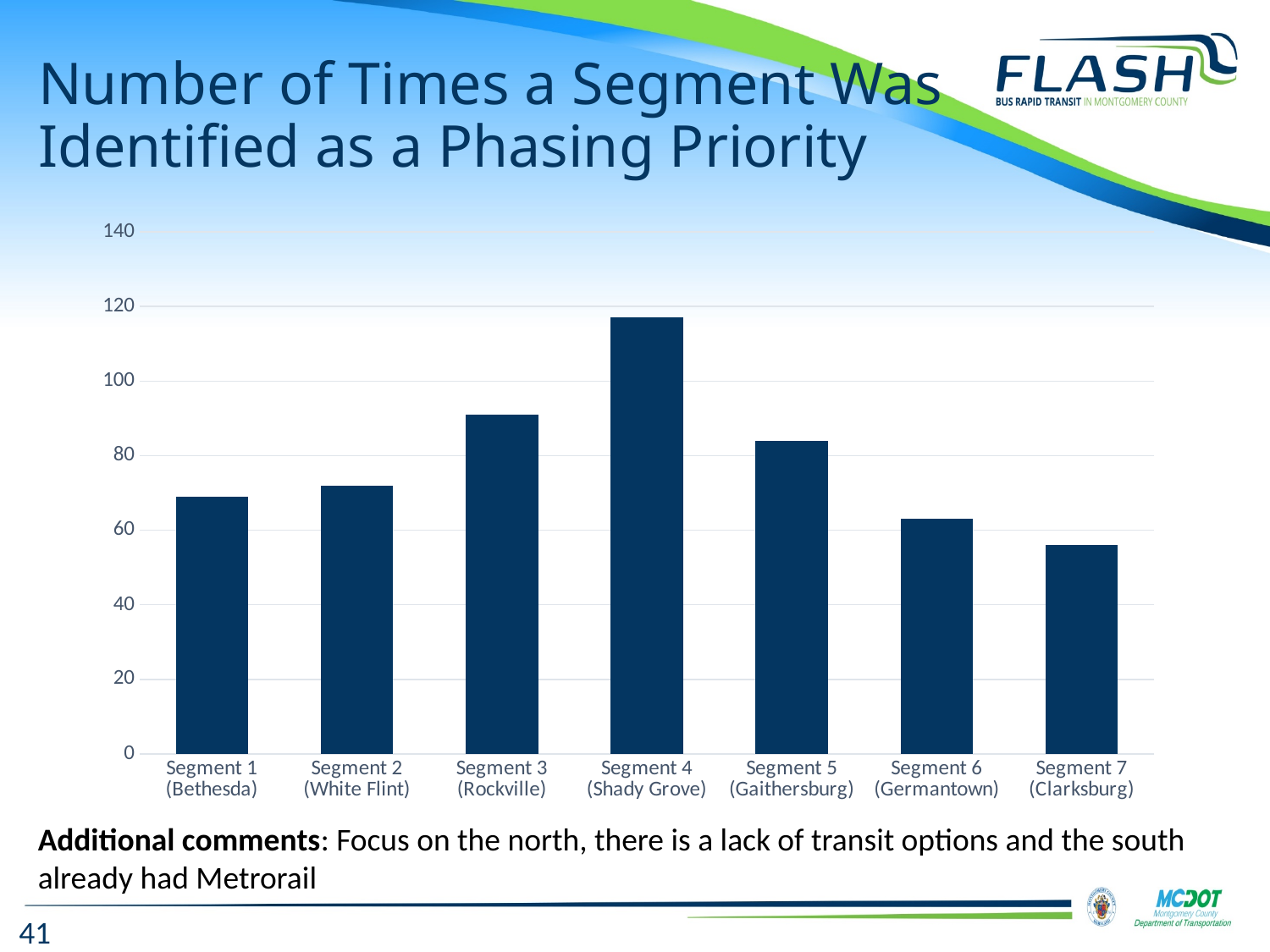
Is the value for Segment 7 (Clarksburg) greater or less than 60? less What is the title of the slide containing the chart? Number of Times a Segment Was Identified as a Phasing Priority Do the values rise or fall from Segment 4 (Shady Grove) to Segment 7 (Clarksburg)? fall Which segment was identified as a phasing priority the fewest times? Segment 7 (Clarksburg) What kind of chart is shown on the slide? Bar chart Is the value for Segment 3 (Rockville) greater or less than 80? greater Is the value for Segment 4 (Shady Grove) greater or less than 100? greater How many segments are shown on the x axis of the chart? 7 Which segment was identified as a phasing priority the most times? Segment 4 (Shady Grove) Which has a higher value, Segment 3 (Rockville) or Segment 5 (Gaithersburg)? Segment 3 (Rockville) Which has a higher value, Segment 2 (White Flint) or Segment 6 (Germantown)? Segment 2 (White Flint)